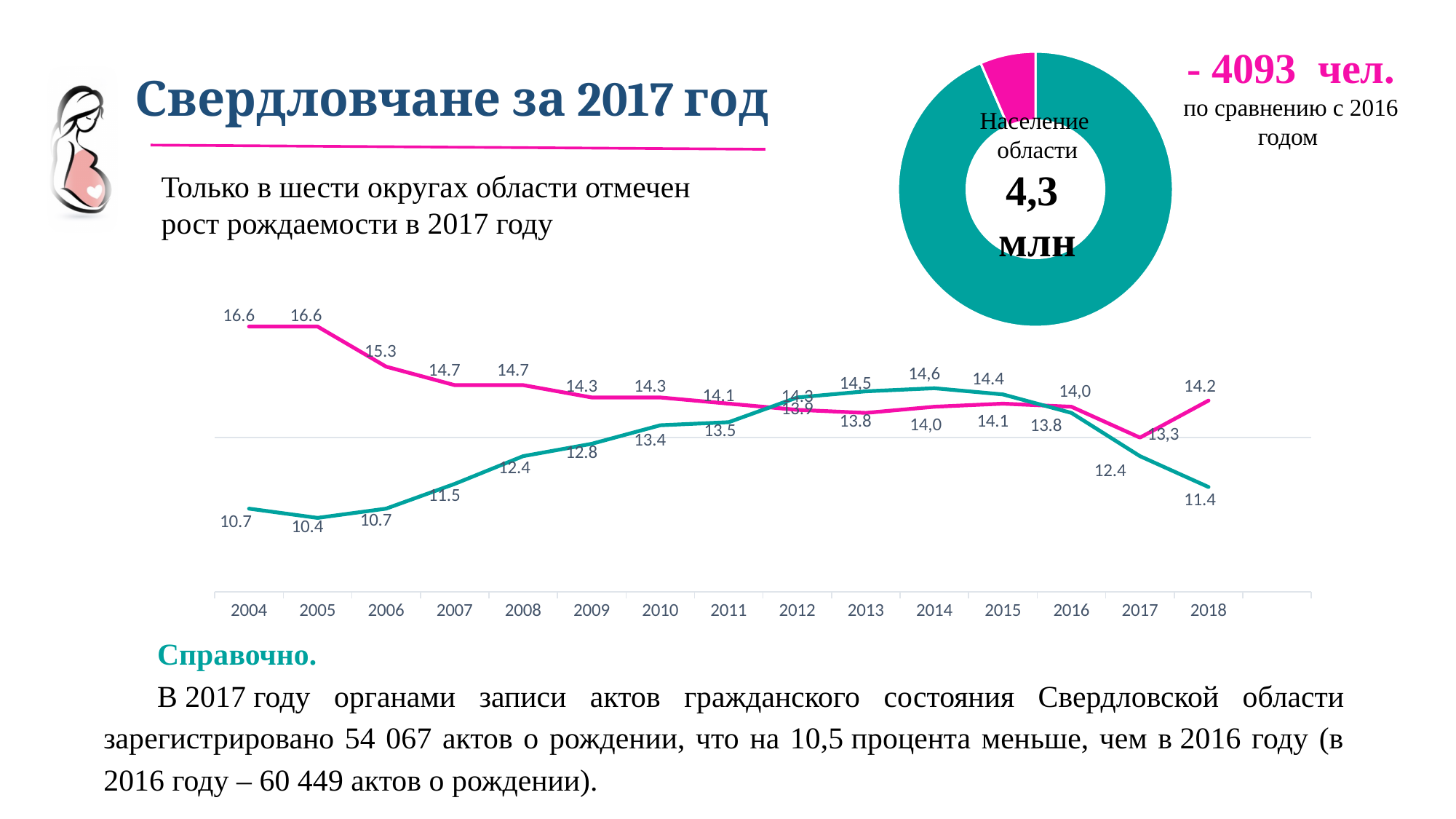
In the line chart, what is the value of the teal line for 2005? 10.4 In the line chart, in which year does the teal line have its lowest value? 2005 In the line chart, what is the value of the pink line for 2004? 16.6 In the line chart, what is the value of the pink line for 2017? 13,3 In the line chart, in which year does the teal line reach its highest value? 2014 In the line chart, what is the value of the teal line for 2018? 11.4 How many years are shown on the x axis of the line chart? 15 What kind of chart is the large chart in the middle of the slide? line chart In the line chart, which line has the higher value in 2008, the pink line or the teal line? pink line In the line chart, does the teal line rise or fall from 2004 to 2010? rise What value is printed in the centre of the donut chart in the top right? 4,3 млн In the line chart, what is the difference between the pink line's value in 2004 and its value in 2018? 2.4